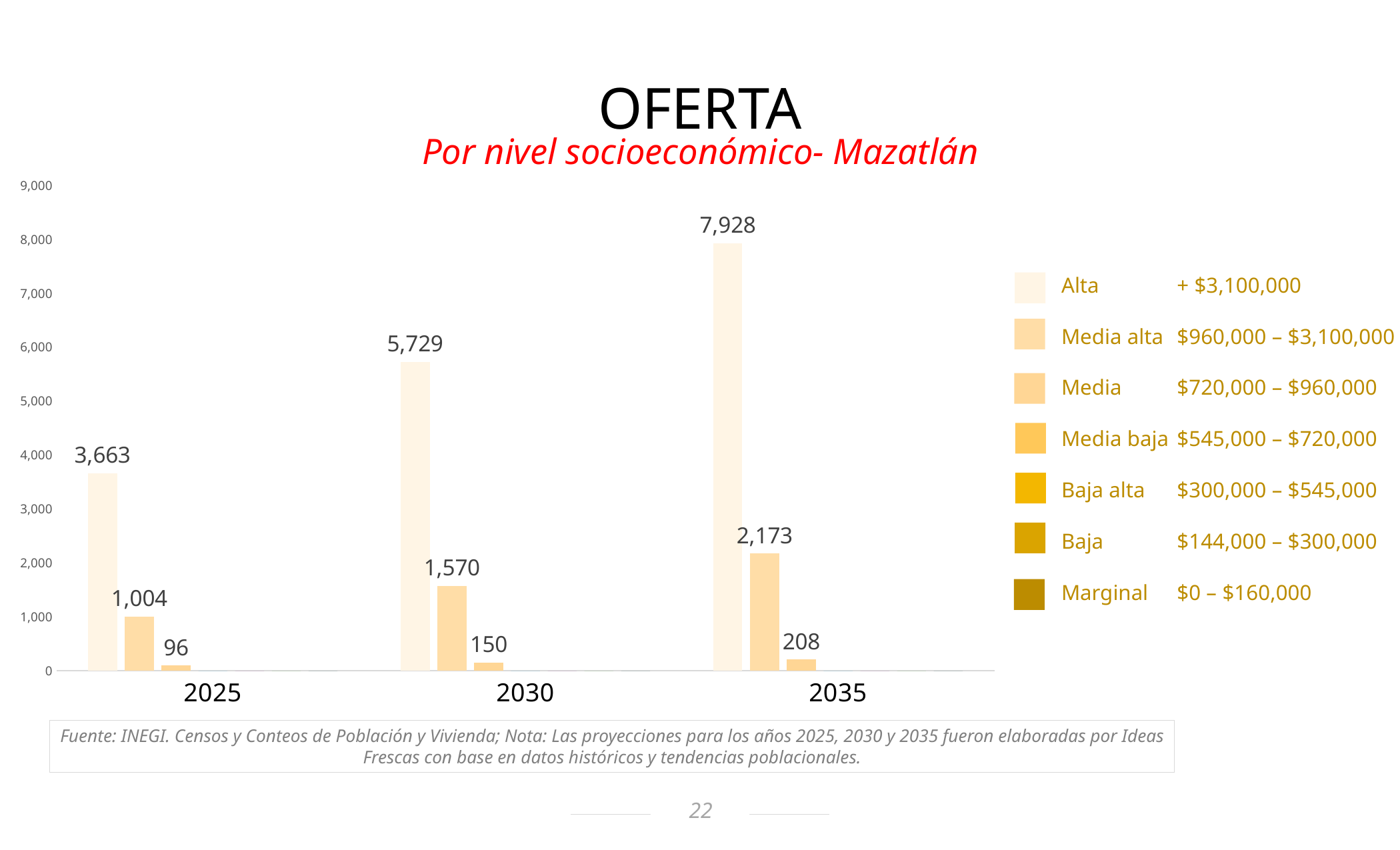
Which is larger, the Media alta value in 2035 or the Media alta value in 2025? 2035 How many years are shown on the x axis? 3 In which year is the Media value lowest? 2025 What is the value for Media in 2025? 96 Does the Alta value rise or fall from 2025 to 2035? rise What is the value for Alta in 2025? 3,663 How many series does the legend list? 7 What is the difference between the Alta values for 2035 and 2030? 2,199 In which year is the Alta value highest? 2035 What is the value for Media alta in 2030? 1,570 What is the value for Alta in 2035? 7,928 What kind of chart is shown on the slide? bar chart